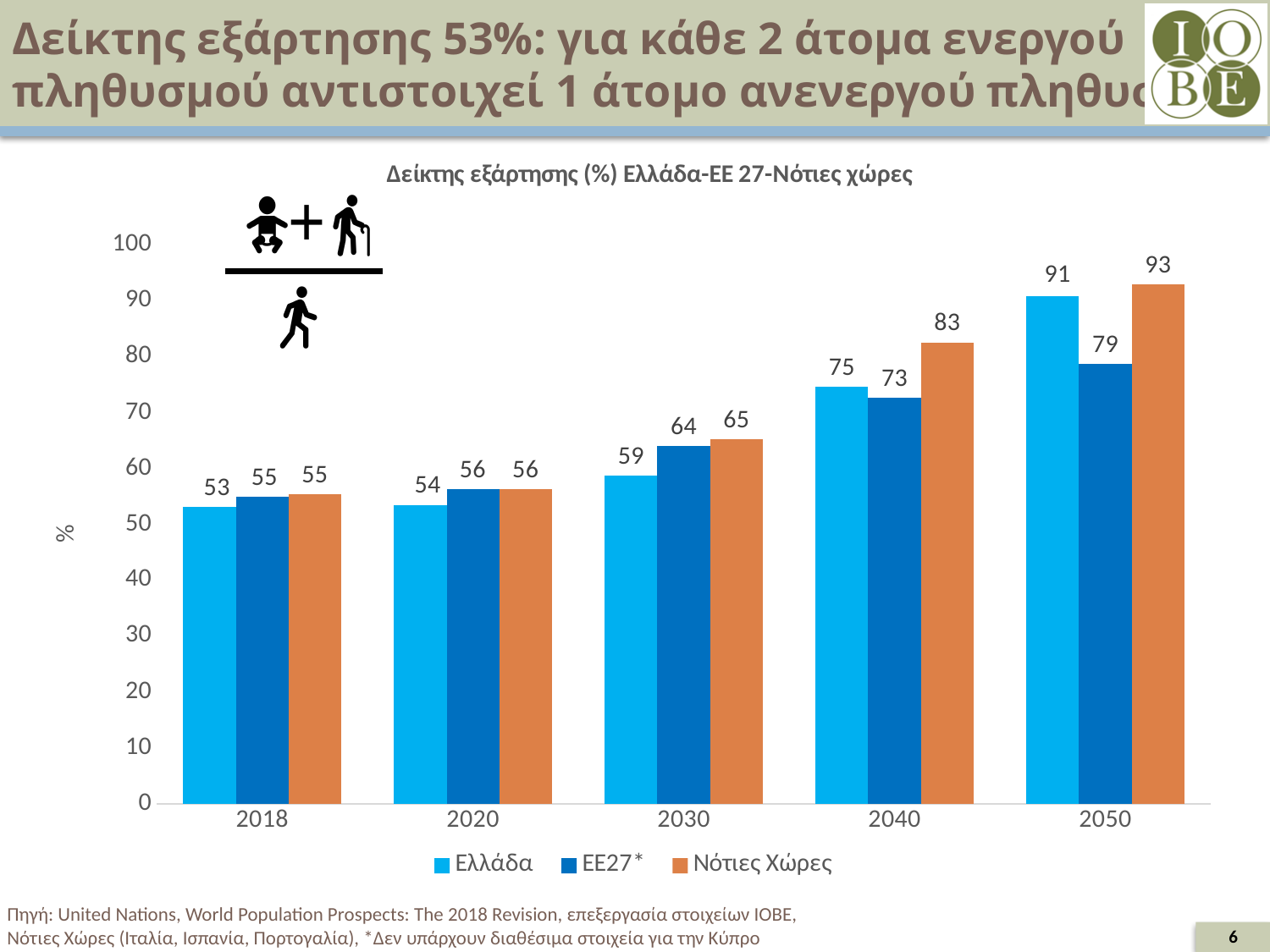
How many series does the legend list? 3 How many years are shown on the x axis? 5 What kind of chart is shown on the slide? bar chart Is the value for Ελλάδα in 2030 greater or less than 70? less What is the value for ΕΕ27* in 2050? 79 What is the value for Ελλάδα in 2018? 53 Do the values for ΕΕ27* rise or fall from 2018 to 2050? rise Which is larger in 2040: the value for Ελλάδα or the value for ΕΕ27*? Ελλάδα In which year is the value for Νότιες Χώρες highest? 2050 In which year is the value for Ελλάδα lowest? 2018 What is the difference between the Νότιες Χώρες value and the ΕΕ27* value in 2050? 14 What is the value for Νότιες Χώρες in 2040? 83